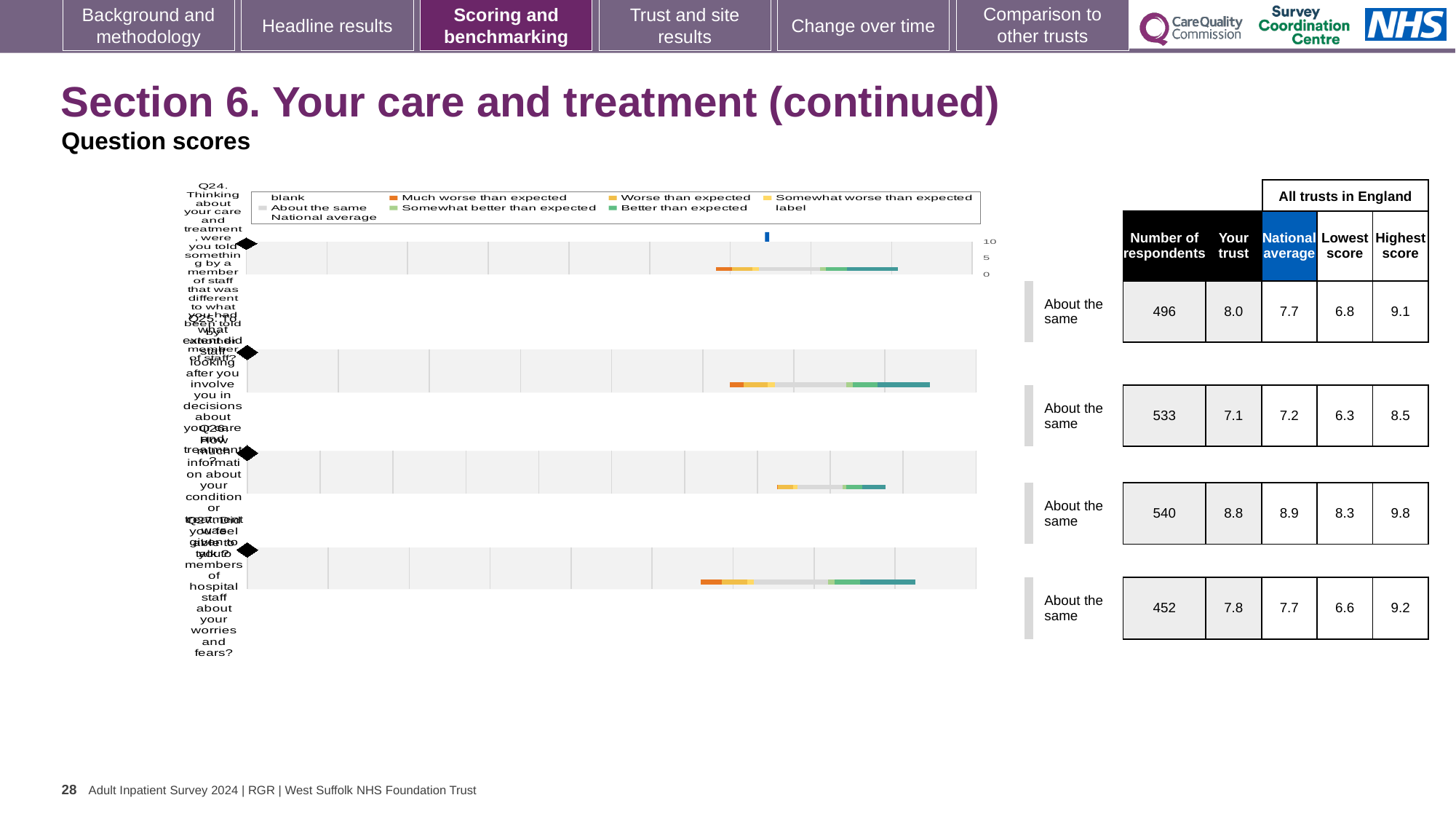
In the table beside the Q25 chart, what is the number of respondents? 533 How many entries does the legend above the charts list? 9 What kind of chart is used for the Q24 to Q27 question scores on this slide? bar chart In the table beside the Q27 chart, what is the national average? 7.7 How many separate question-score bar charts are shown on the slide? 4 In the table beside the Q24 chart, what is the 'Your trust' score? 8.0 Which legend entry is shown in orange? Much worse than expected Which of the four questions (Q24–Q27) has the lowest number of respondents in the table? Q27 In the table beside the Q26 chart, what is the highest score among all trusts in England? 9.8 What benchmark category is shown beside the Q24 chart? About the same What is the highest tick value shown on the horizontal axis of the top chart? 10 Which of the four questions (Q24–Q27) has the highest 'Your trust' score in the table? Q26